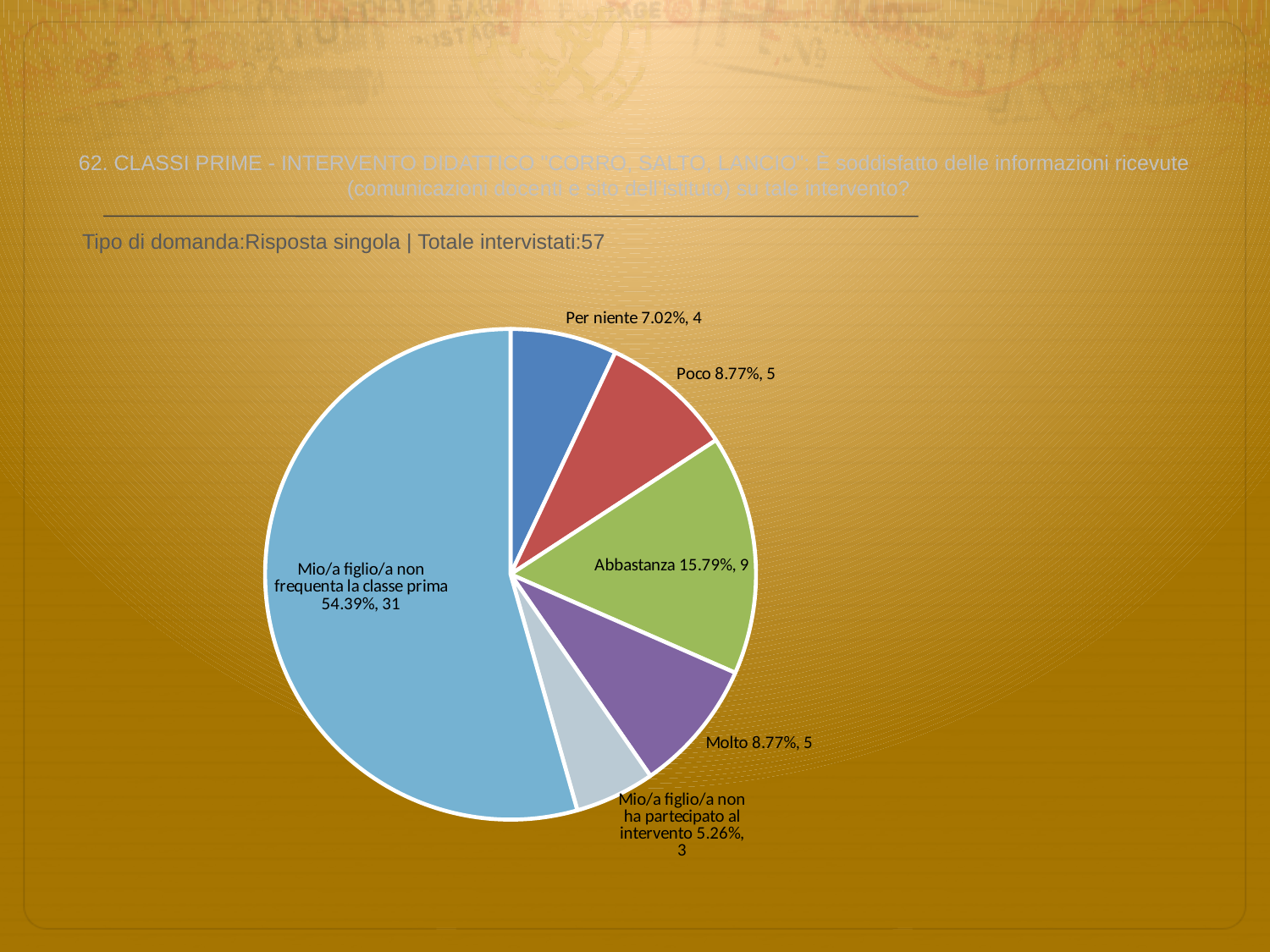
What percentage share does 'Per niente' have? 7.02% Which category has the smallest slice? Mio/a figlio/a non ha partecipato al intervento What percentage share does 'Mio/a figlio/a non frequenta la classe prima' have? 54.39% What is the count for 'Abbastanza'? 9 What is the total number of respondents stated on the slide? 57 What is the count for 'Molto'? 5 What kind of chart is shown on the slide? pie chart What colour is the 'Abbastanza' slice? green Which has a larger count, 'Per niente' or 'Abbastanza'? Abbastanza What is the difference in count between 'Abbastanza' and 'Poco'? 4 Which category has the largest slice? Mio/a figlio/a non frequenta la classe prima How many slices does the pie chart have? 6